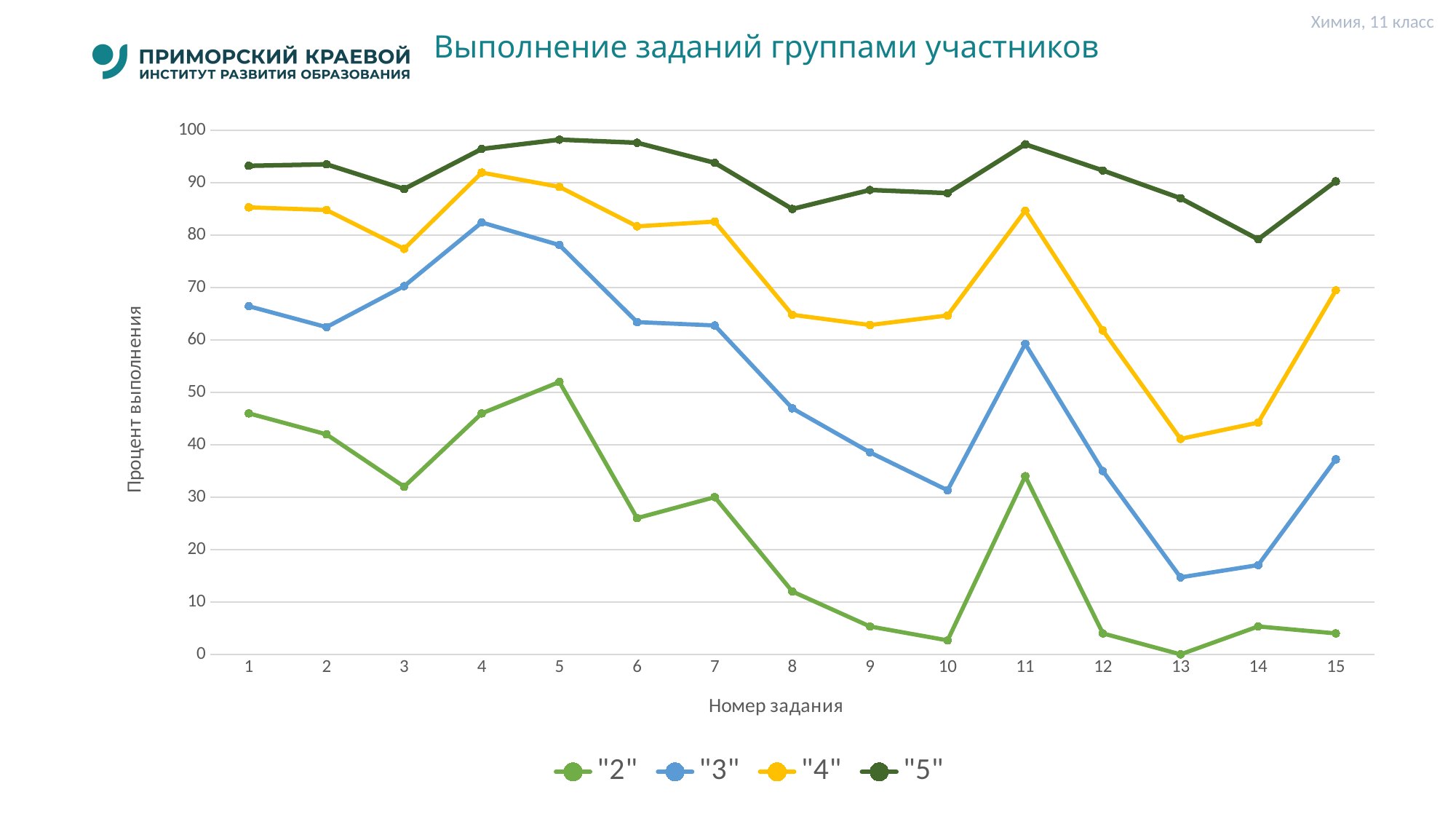
What is the title of the y axis? Процент выполнения Is the value for series "2" at task 1 greater or less than 40? greater For series "2", at which task number is the value highest? 5 How many series does the legend list? 4 Is the value for series "3" at task 10 greater or less than 40? less Is the value for series "5" at task 14 greater or less than 90? less For series "3", which is larger: the value at task 11 or the value at task 12? task 11 For series "2", at which task number is the value lowest? 13 For series "5", at which task number is the value lowest? 14 What kind of chart is shown on the slide? line chart How many task numbers are plotted along the x axis? 15